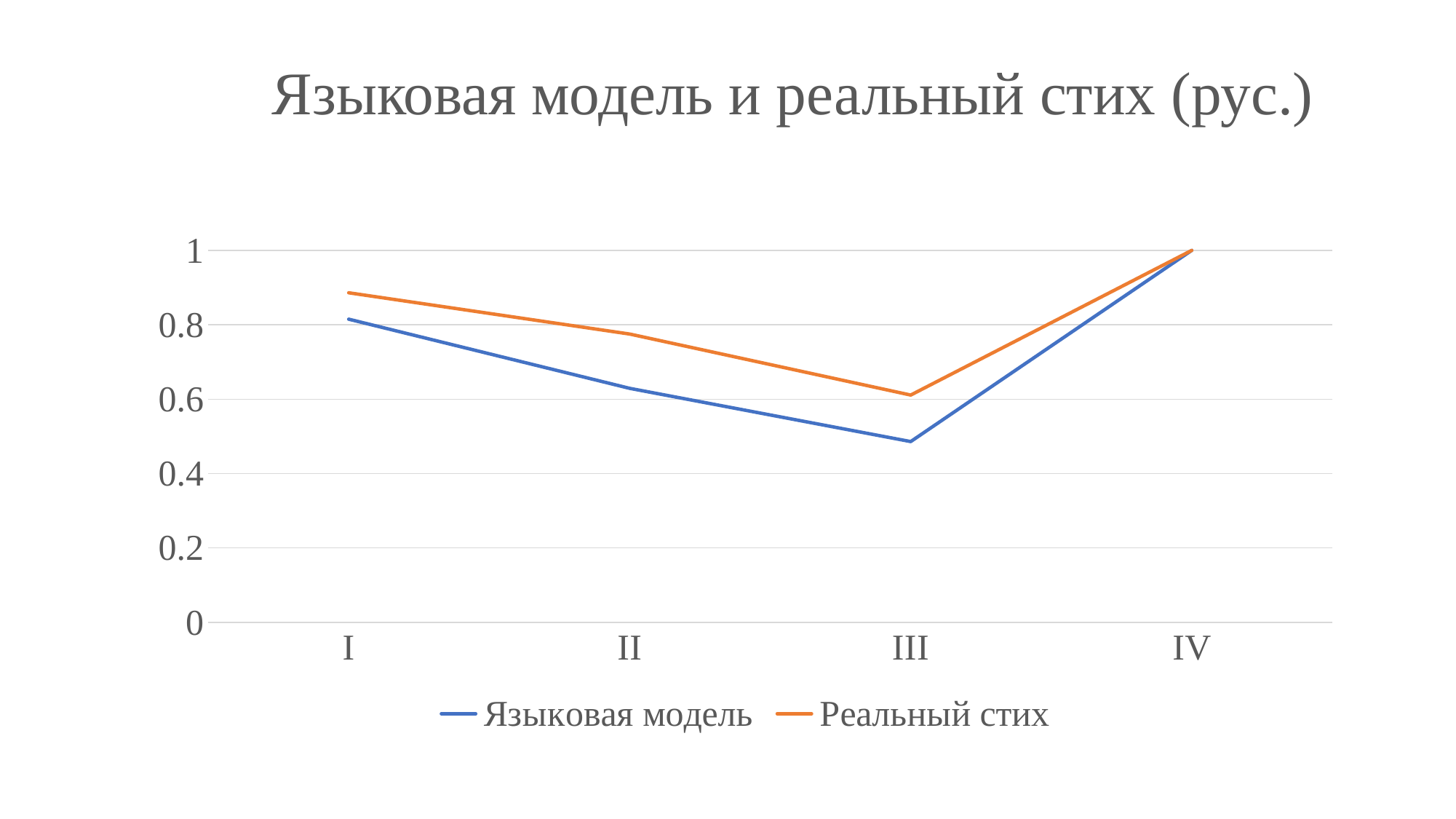
At III, which series has the larger value, Языковая модель or Реальный стих? Реальный стих How many categories are shown on the x axis? 4 At which category is Языковая модель lowest? III Does the Языковая модель line rise or fall from I to III? fall Is the value for Языковая модель at III greater or less than 0.6? less At which category is Реальный стих lowest? III How many series does the legend list? 2 What is the value of Реальный стих at IV? 1 What kind of chart is shown on the slide? line chart At which category is Языковая модель highest? IV Is the value for Реальный стих at I greater or less than 0.8? greater What is the value of Языковая модель at IV? 1